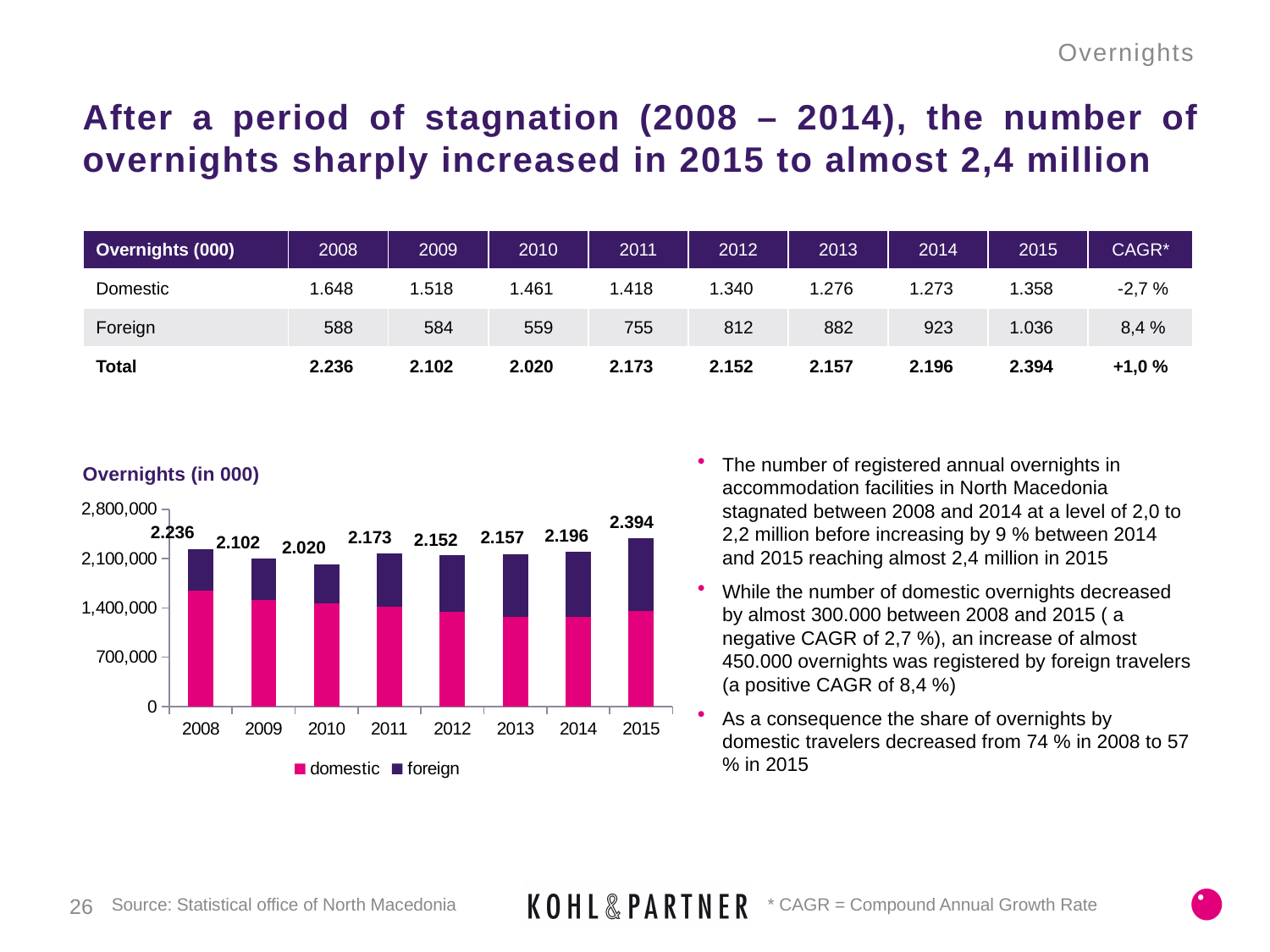
How many series does the legend of the chart list? 2 Is the domestic segment for 2013 greater or less than 1,400,000? less Which year has the larger total overnights, 2011 or 2012? 2011 Which year has the highest total overnights in the chart? 2015 Is the domestic segment for 2008 greater or less than 1,400,000? greater How many years are shown on the x axis of the chart? 8 What is the total overnights value labelled on the bar for 2010? 2.020 What kind of chart is shown on the slide? Stacked bar chart Do the total overnights rise or fall from 2012 to 2015? rise Which year has the lowest total overnights in the chart? 2010 By how much does the total labelled for 2015 exceed the total labelled for 2008? 158 What is the total overnights value labelled on the bar for 2015? 2.394